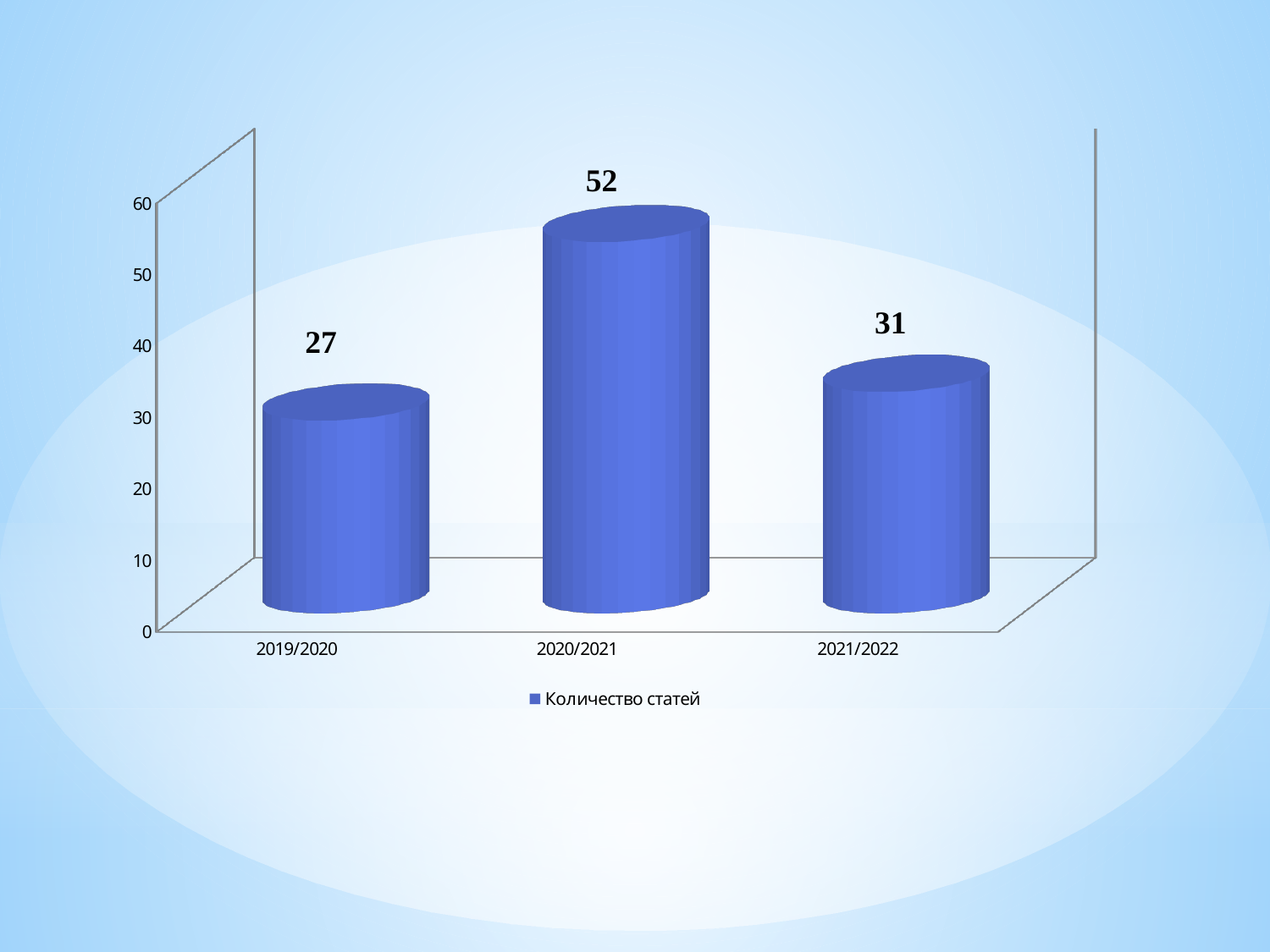
Which category has the highest value? 2020/2021 What kind of chart is this? bar chart What is the value for 2019/2020? 27 How many categories are shown on the x axis? 3 What is the difference between the values for 2021/2022 and 2019/2020? 4 Which is larger, the value for 2021/2022 or the value for 2019/2020? 2021/2022 What is the value for 2020/2021? 52 What is the value for 2021/2022? 31 What is the difference between the values for 2020/2021 and 2019/2020? 25 What is the name of the series in the legend? Количество статей How many series does the legend list? 1 Which category has the lowest value? 2019/2020